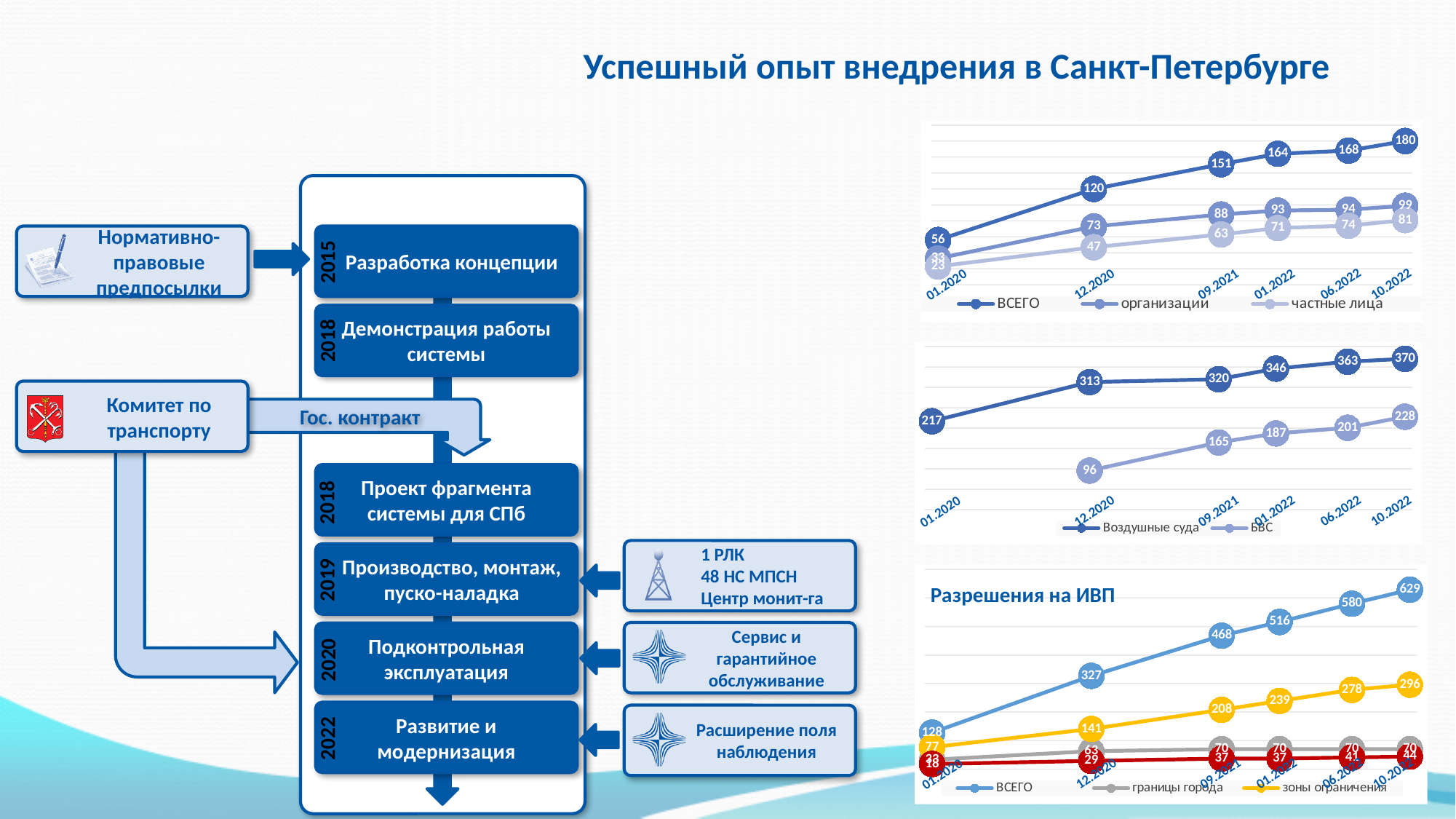
In the middle chart, what is the value of Воздушные суда at 01.2020? 217 What kind of chart is the chart titled Разрешения на ИВП? line chart In the chart titled Разрешения на ИВП, what is the value of ВСЕГО at 10.2022? 629 In the top chart, what is the value of организации at 12.2020? 73 In the middle chart, which series has the higher value at 06.2022, Воздушные суда or БВС? Воздушные суда In the top chart, what is the value of частные лица at 01.2022? 71 In the middle chart, what is the value of БВС at 10.2022? 228 In the chart titled Разрешения на ИВП, does the ВСЕГО series rise or fall from 01.2020 to 10.2022? rise How many series does the legend of the top chart list? 3 In the chart titled Разрешения на ИВП, what is the value of зоны ограничения at 09.2021? 208 In the top chart, what is the difference between ВСЕГО at 10.2022 and ВСЕГО at 01.2020? 124 In the top chart, what is the value of ВСЕГО at 10.2022? 180